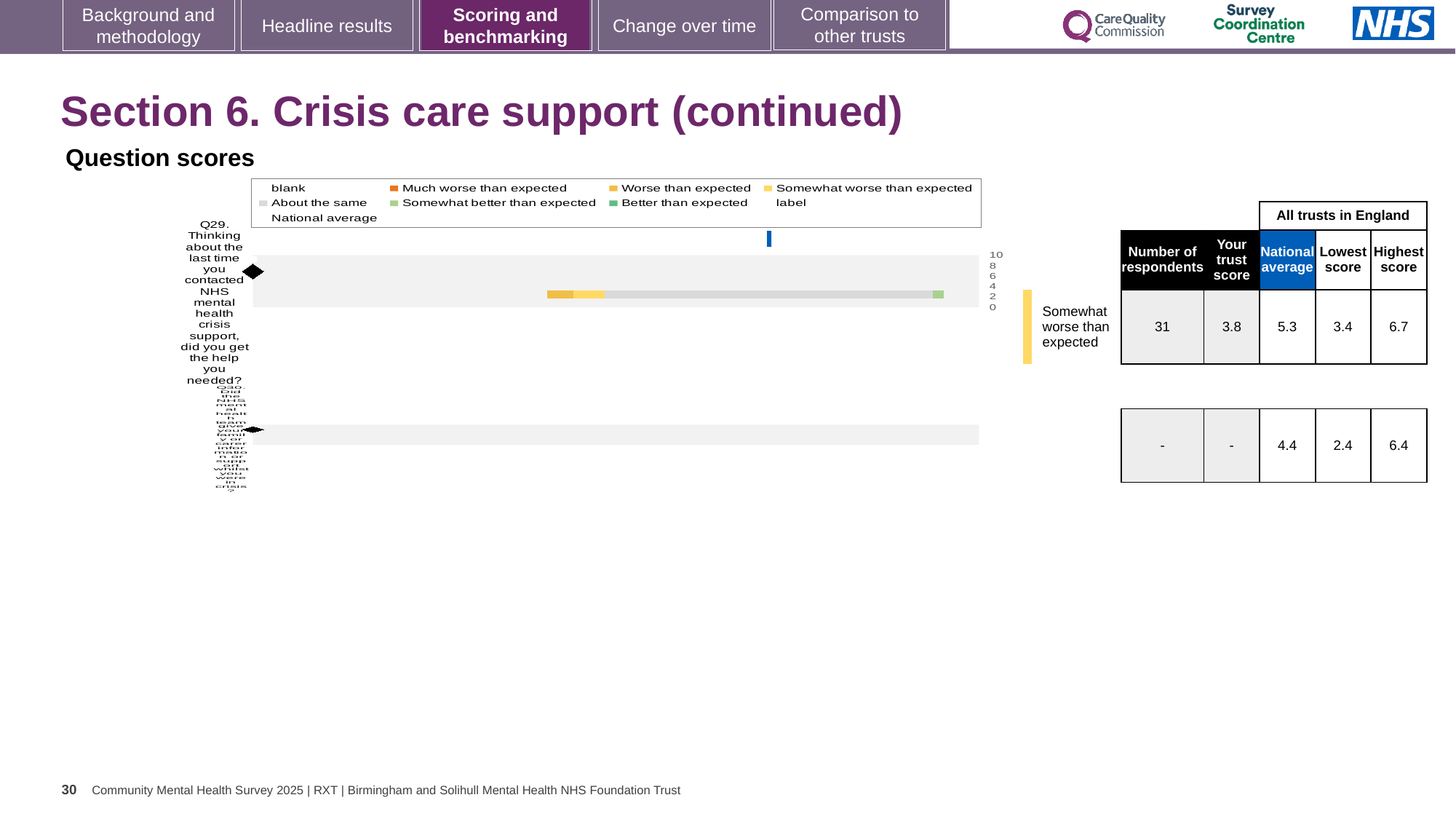
What is the highest score across all trusts in England for Q29? 6.7 How many respondents answered Q29? 31 What kind of chart is shown under 'Question scores'? Bar chart What benchmark category label is shown for Q29? Somewhat worse than expected What is the lowest score across all trusts in England for Q30? 2.4 For Q29, which is larger: the trust score or the national average? National average How many questions are plotted in the chart? 2 How much higher is the national average than the trust score for Q29? 1.5 What is the trust score for Q29 (Thinking about the last time you contacted NHS mental health crisis support, did you get the help you needed?)? 3.8 What is the difference between the highest and lowest scores for Q29? 3.3 What is the national average for Q30? 4.4 What is the national average for Q29? 5.3